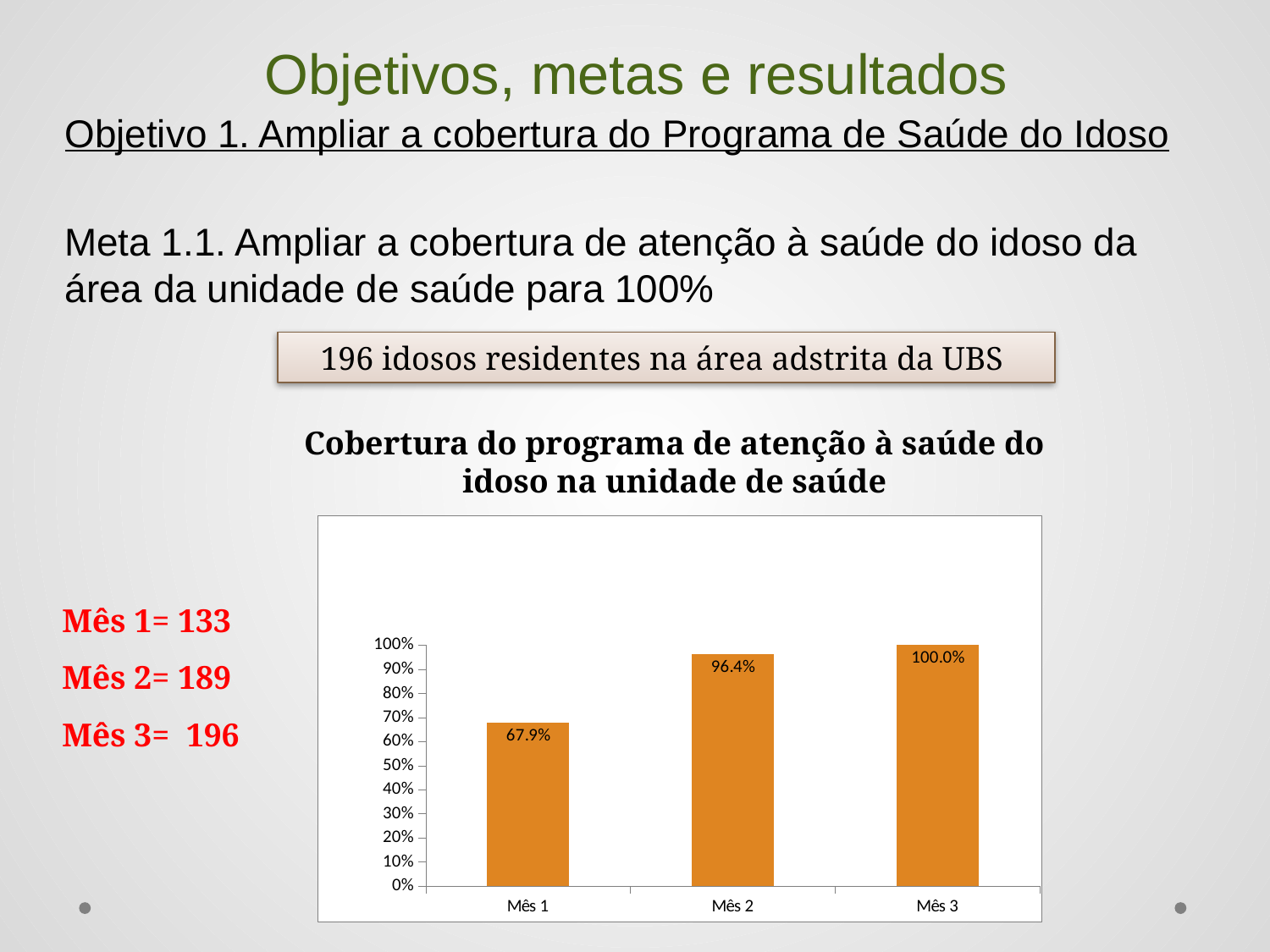
Is the value for Mês 1 greater or less than 70%? less Do the values rise or fall from Mês 1 to Mês 3? rise What is the difference between the values for Mês 3 and Mês 2? 3.6% What kind of chart is shown? bar chart Which is larger, the value for Mês 1 or the value for Mês 2? Mês 2 What is the value for Mês 2? 96.4% What is the value for Mês 1? 67.9% What is the difference between the values for Mês 2 and Mês 1? 28.5% How many categories are shown on the x axis? 3 What is the value for Mês 3? 100.0% Which month has the lowest value? Mês 1 Which month has the highest value? Mês 3